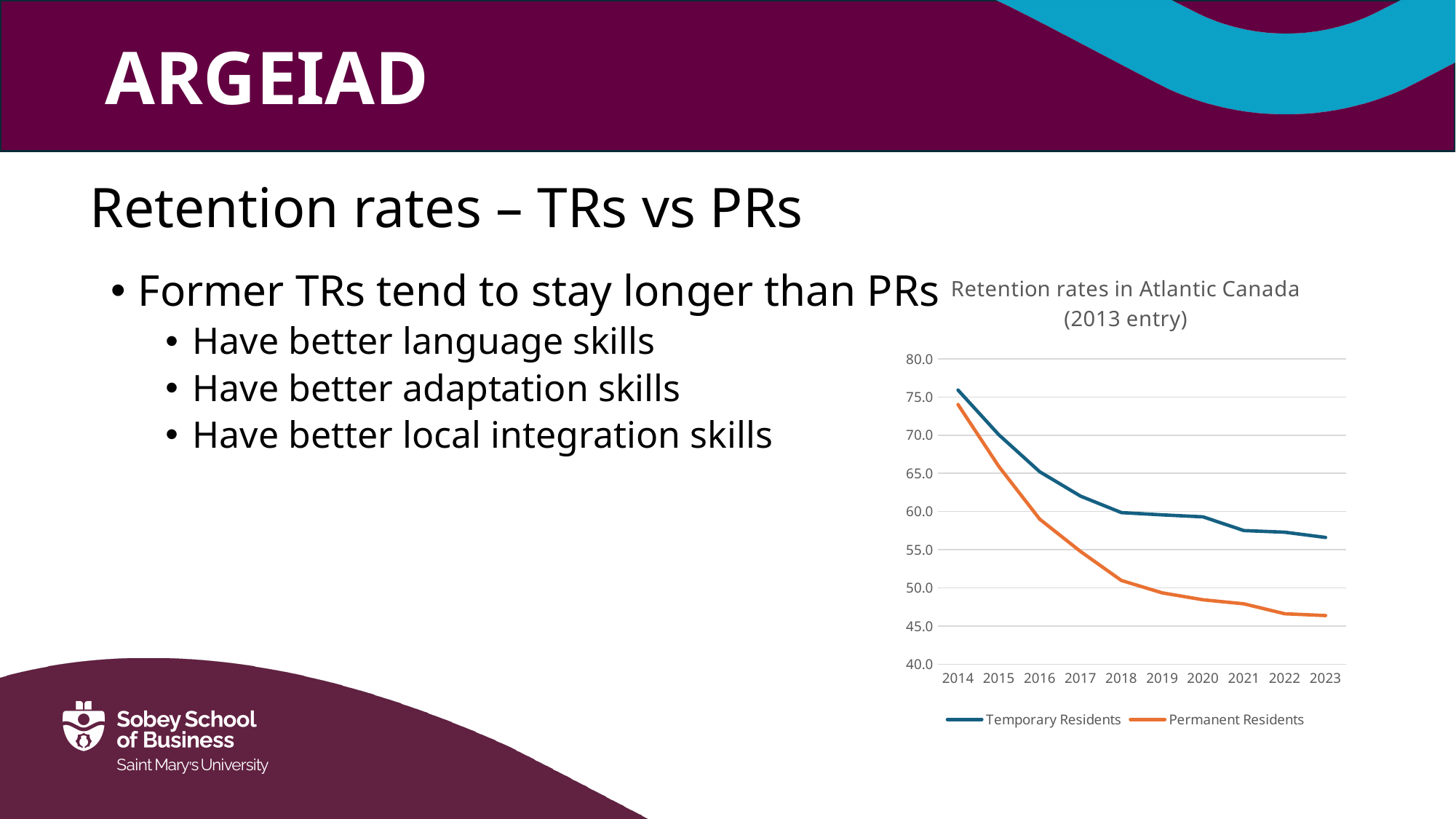
Is the value for Permanent Residents in 2023 greater or less than 50.0? less What is the title of the chart? Retention rates in Atlantic Canada (2013 entry) In which year is the retention rate for Permanent Residents lowest? 2023 How many years are shown on the x axis of the chart? 10 Do the retention rates for Temporary Residents rise or fall from 2014 to 2023? fall What kind of chart is shown on the slide? line chart Is the value for Temporary Residents in 2023 greater or less than 55.0? greater In 2023, which series has the higher retention rate, Temporary Residents or Permanent Residents? Temporary Residents Is the value for Permanent Residents in 2014 greater or less than 70.0? greater How many series does the legend of the chart list? 2 Do the retention rates for Permanent Residents rise or fall from 2014 to 2023? fall In which year is the retention rate for Temporary Residents highest? 2014